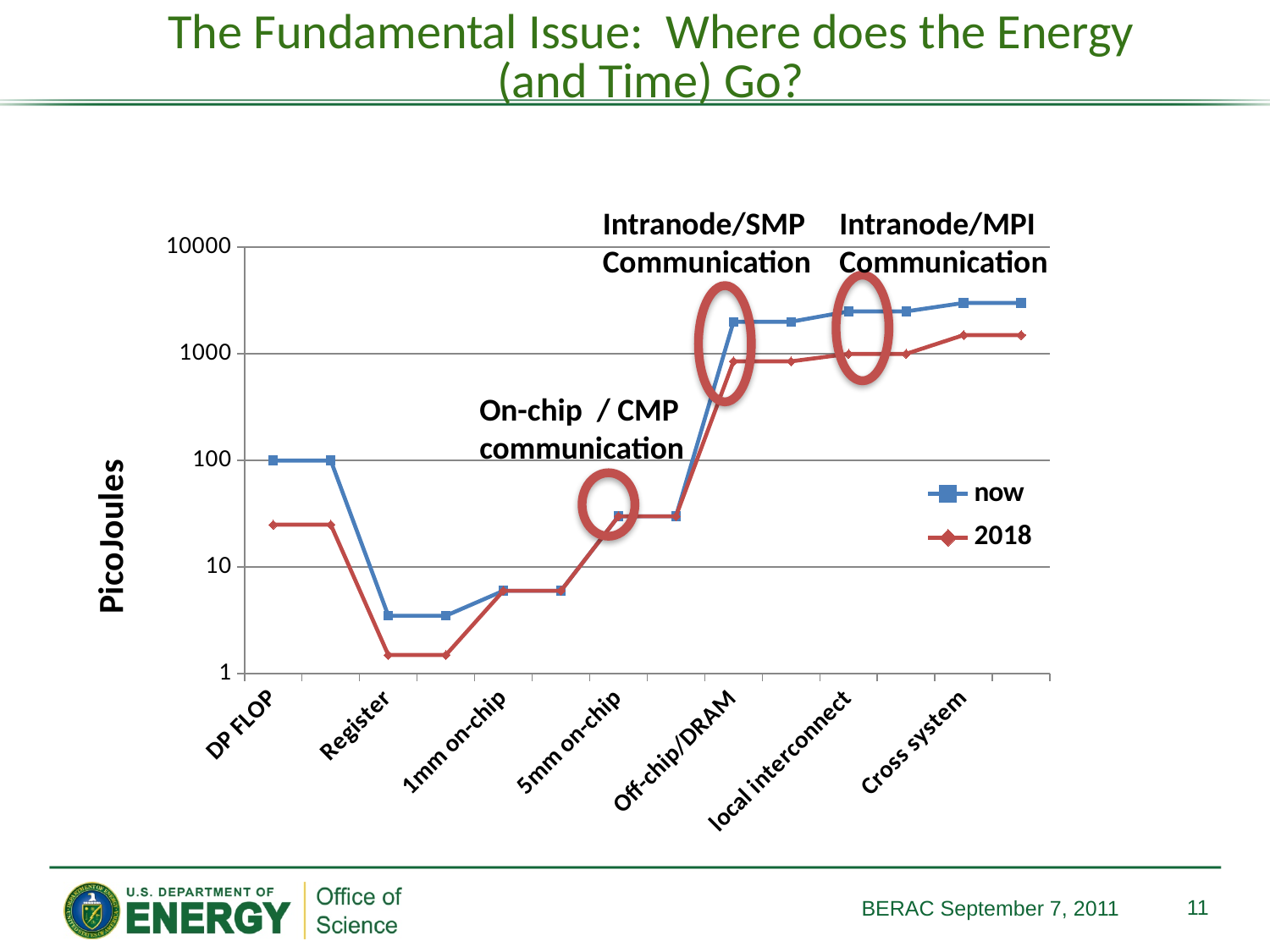
What is the value of the 'now' series for DP FLOP? 100 Is the value of the 'now' series for Register greater or less than 10? less For which labeled category is the '2018' series lowest? Register What is the label on the vertical axis? PicoJoules What is the value of the '2018' series for local interconnect? 1000 Which series has the larger value for Cross system, 'now' or '2018'? now Is the value of the 'now' series for Off-chip/DRAM greater or less than 1000? greater Is the value of the '2018' series for DP FLOP greater or less than 100? less Do the values rise or fall between 5mm on-chip and Off-chip/DRAM? rise What kind of chart is shown on the slide? line chart What are the two series named in the legend? now and 2018 How many series does the legend list? 2